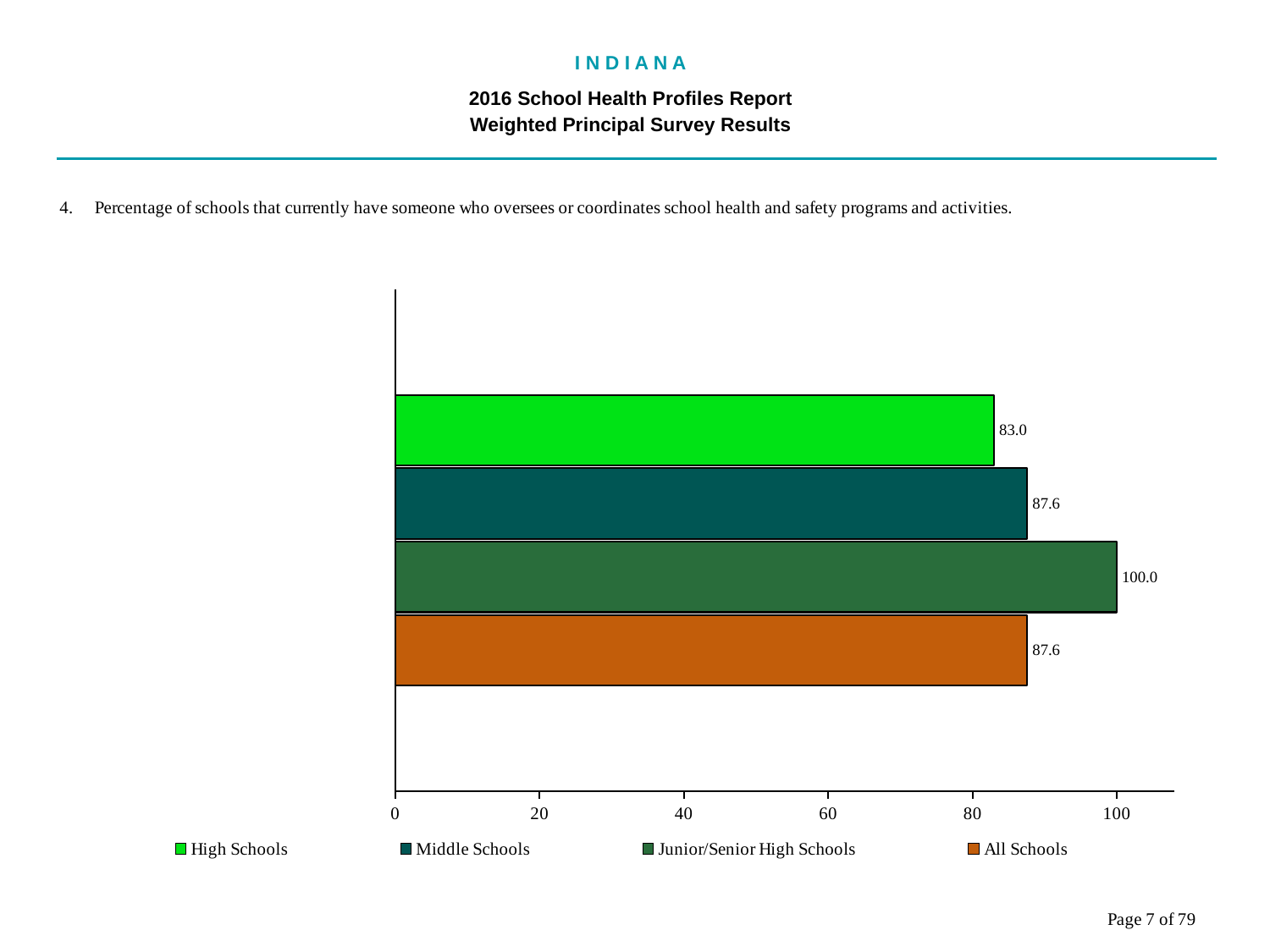
What is the value for Middle Schools? 87.6 Is the value for High Schools greater or less than 80? greater What is the value for Junior/Senior High Schools? 100.0 How many series does the legend list? 4 Which series has the highest value? Junior/Senior High Schools What is the value for All Schools? 87.6 Which is larger, the value for Middle Schools or the value for High Schools? Middle Schools What is the difference between the values for Junior/Senior High Schools and High Schools? 17.0 What is the value for High Schools? 83.0 What is the difference between the values for Middle Schools and High Schools? 4.6 Which series has the lowest value? High Schools What kind of chart is shown on the slide? bar chart